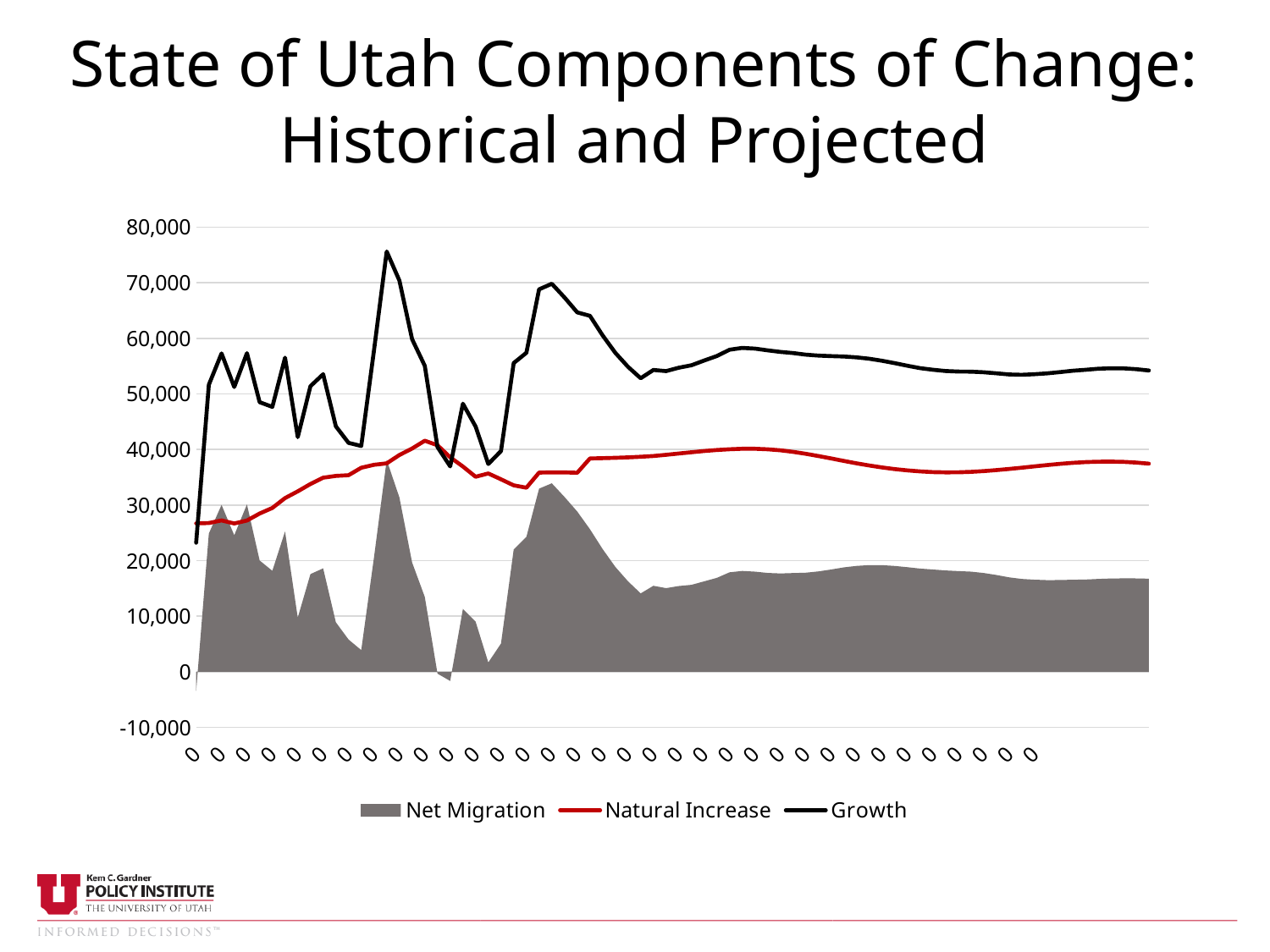
How many series does the chart's legend list? 3 Does the Net Migration series ever fall below 0 on the chart? Yes What is the highest value shown on the vertical axis? 80,000 Which series has the lowest values across the chart? Net Migration Is the peak value of the Net Migration area greater or less than 30,000? greater What is the title of the chart on the slide? State of Utah Components of Change: Historical and Projected What colour is the Natural Increase line? Red Is the peak value of the Natural Increase line greater or less than 50,000? less Which series reaches the highest value anywhere on the chart? Growth Does the Natural Increase line generally rise or fall from the left of the chart to the right? Rise